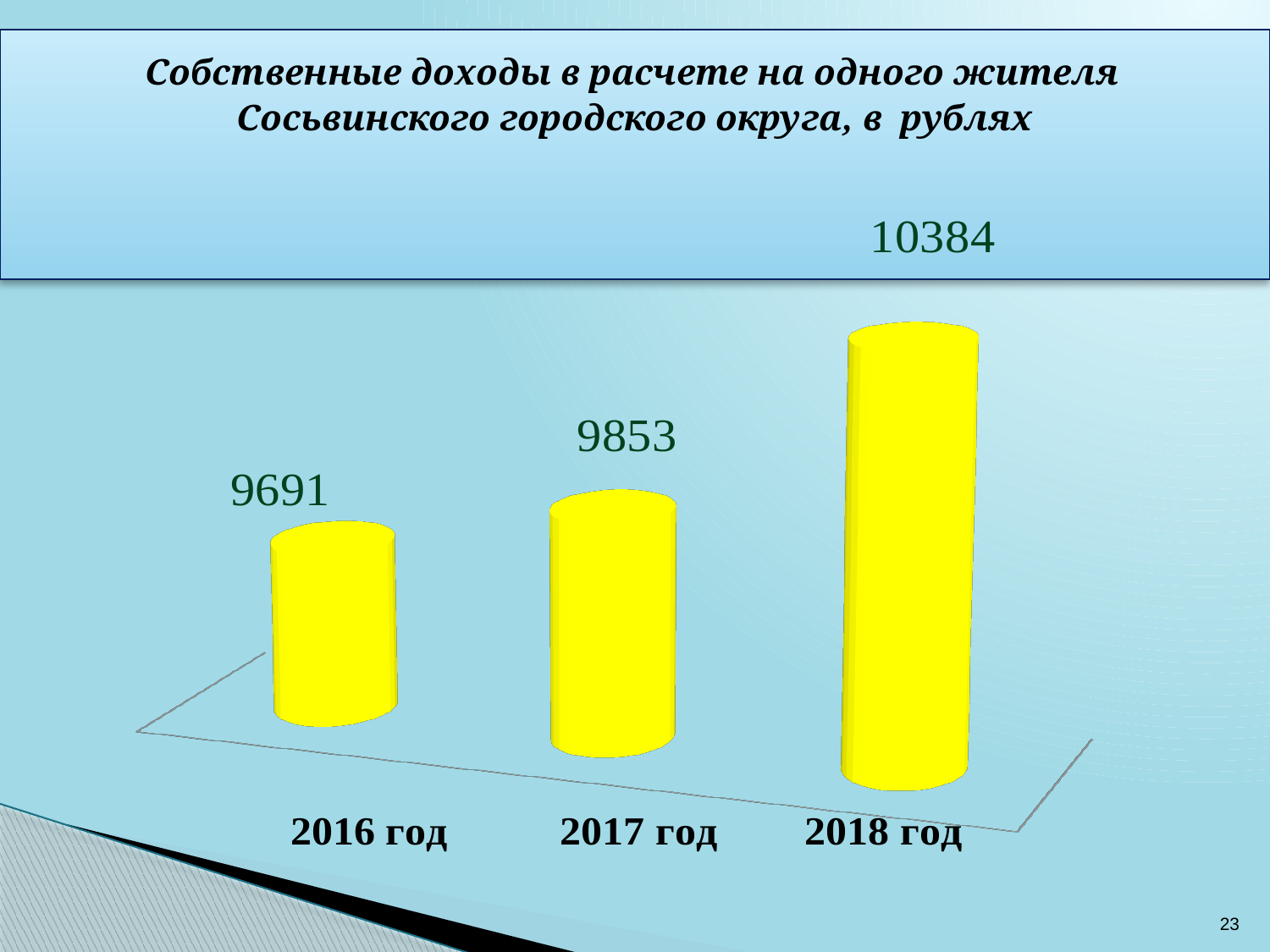
Do the values rise or fall from 2016 год to 2018 год? rise Which is larger, the value for 2016 год or the value for 2018 год? 2018 год What is the difference between the values for 2018 год and 2017 год? 531 Which year has the lowest value? 2016 год How many years are shown on the chart? 3 What kind of chart is shown on the slide? bar chart What is the value for 2017 год? 9853 What is the value for 2016 год? 9691 What is the value for 2018 год? 10384 What is the difference between the values for 2017 год and 2016 год? 162 Which year has the highest value? 2018 год What colour are the bars on the chart? yellow